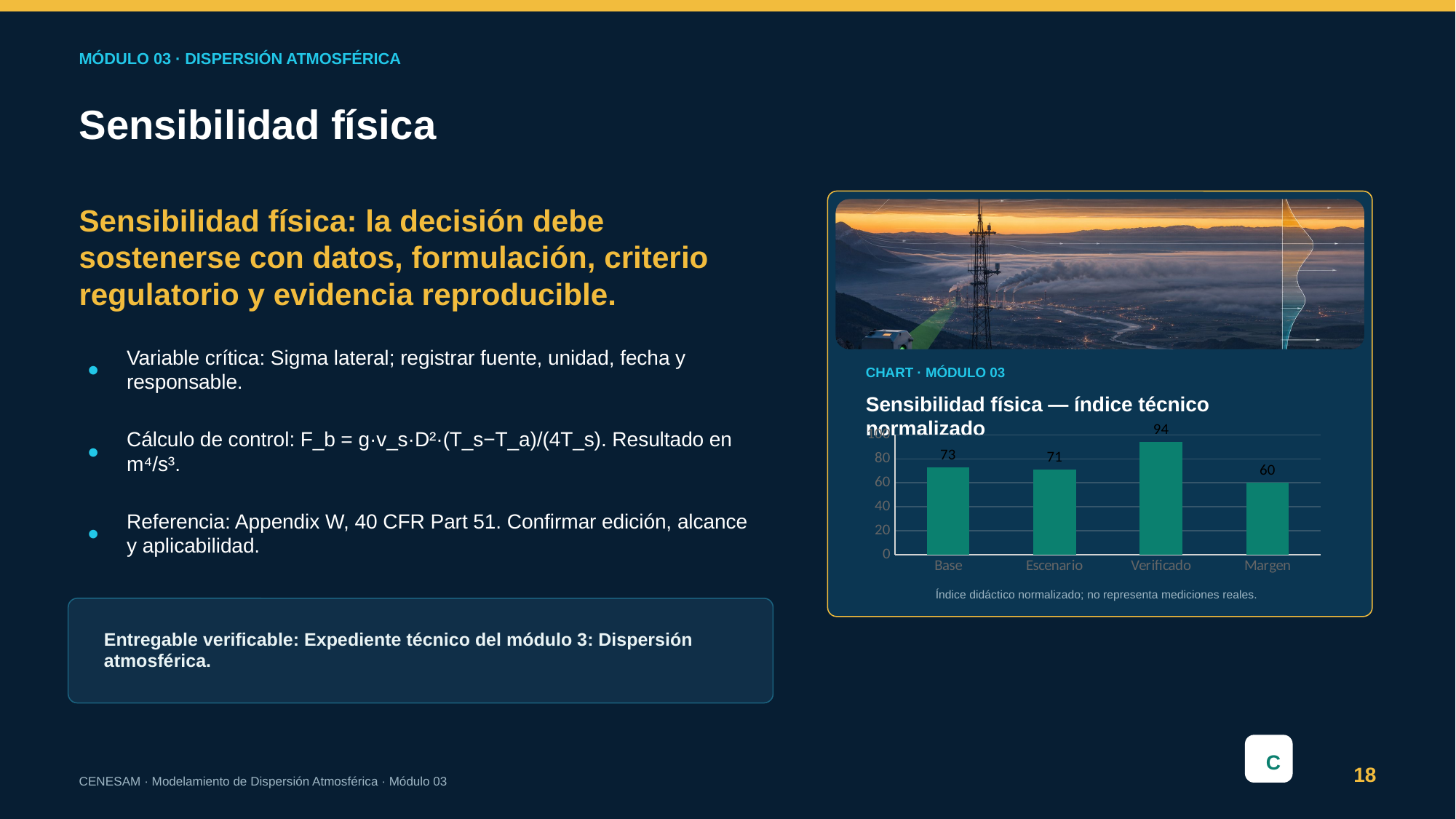
What is the value for Verificado? 94 What kind of chart is shown? bar chart Which category has the lowest value? Margen Is the value for Verificado greater or less than 80? greater What is the difference between the values for Verificado and Margen? 34 What is the value for Base? 73 How many categories are shown on the x axis? 4 What is the value for Escenario? 71 Which is larger, the value for Base or the value for Margen? Base What is the title of the chart? Sensibilidad física — índice técnico normalizado Which category has the highest value? Verificado What is the value for Margen? 60